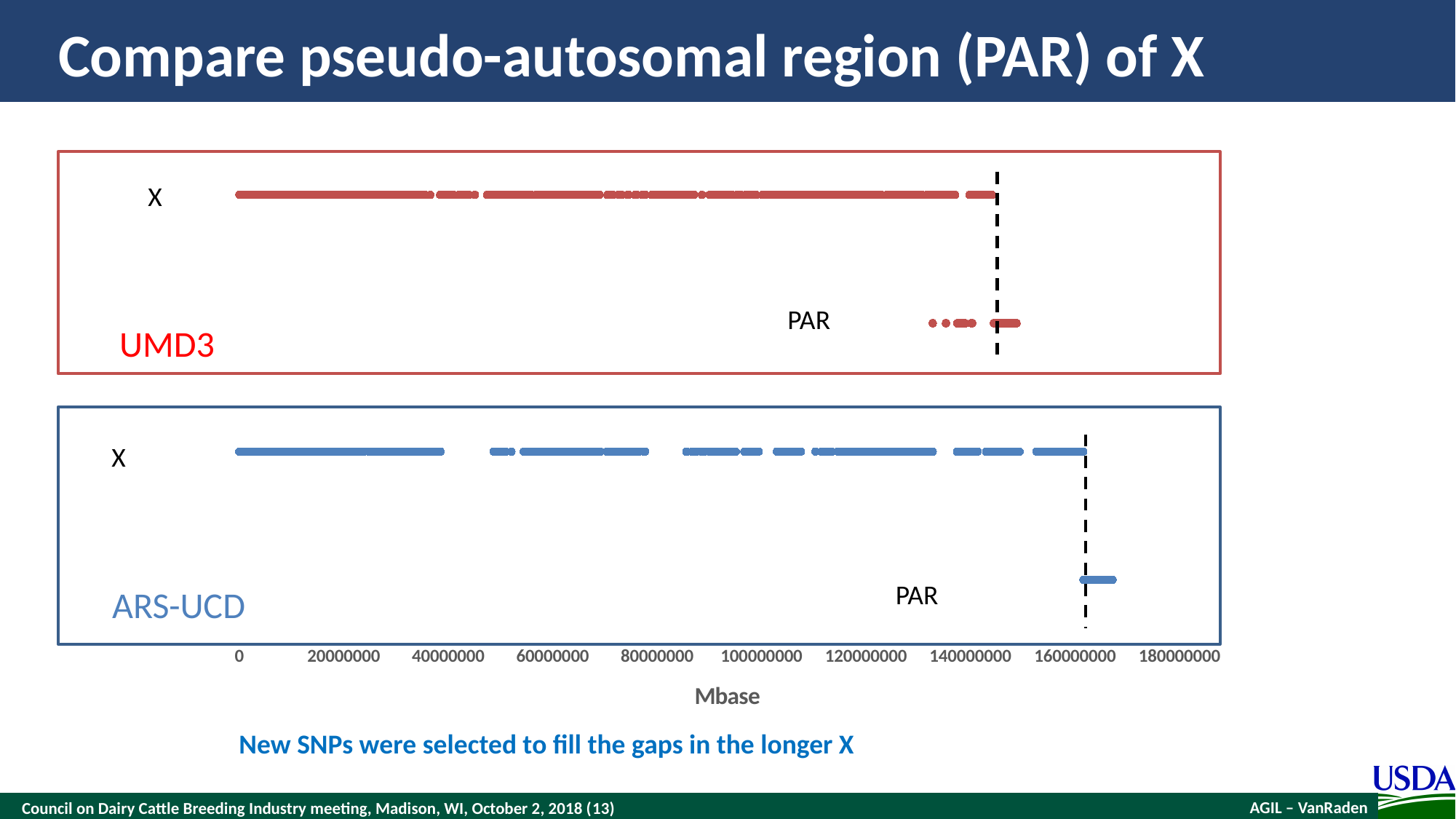
In the ARS-UCD chart, is the start of the PAR series greater or less than 140000000? greater In the UMD3 chart, is the start of the PAR series greater or less than 120000000? greater How many labelled series does the ARS-UCD chart show? 2 What is the label of the horizontal axis shared by the two charts? Mbase In the UMD3 chart, is the far end of the X series greater or less than 140000000? greater What kind of chart is used in the UMD3 panel to show SNP positions along the X chromosome? scatter (dot) plot Which assembly's PAR series is located further along the Mbase axis, UMD3 or ARS-UCD? ARS-UCD How many chart panels are shown on the slide? 2 What is the largest tick value shown on the horizontal axis? 180000000 Which assembly's X series extends further along the Mbase axis, UMD3 or ARS-UCD? ARS-UCD